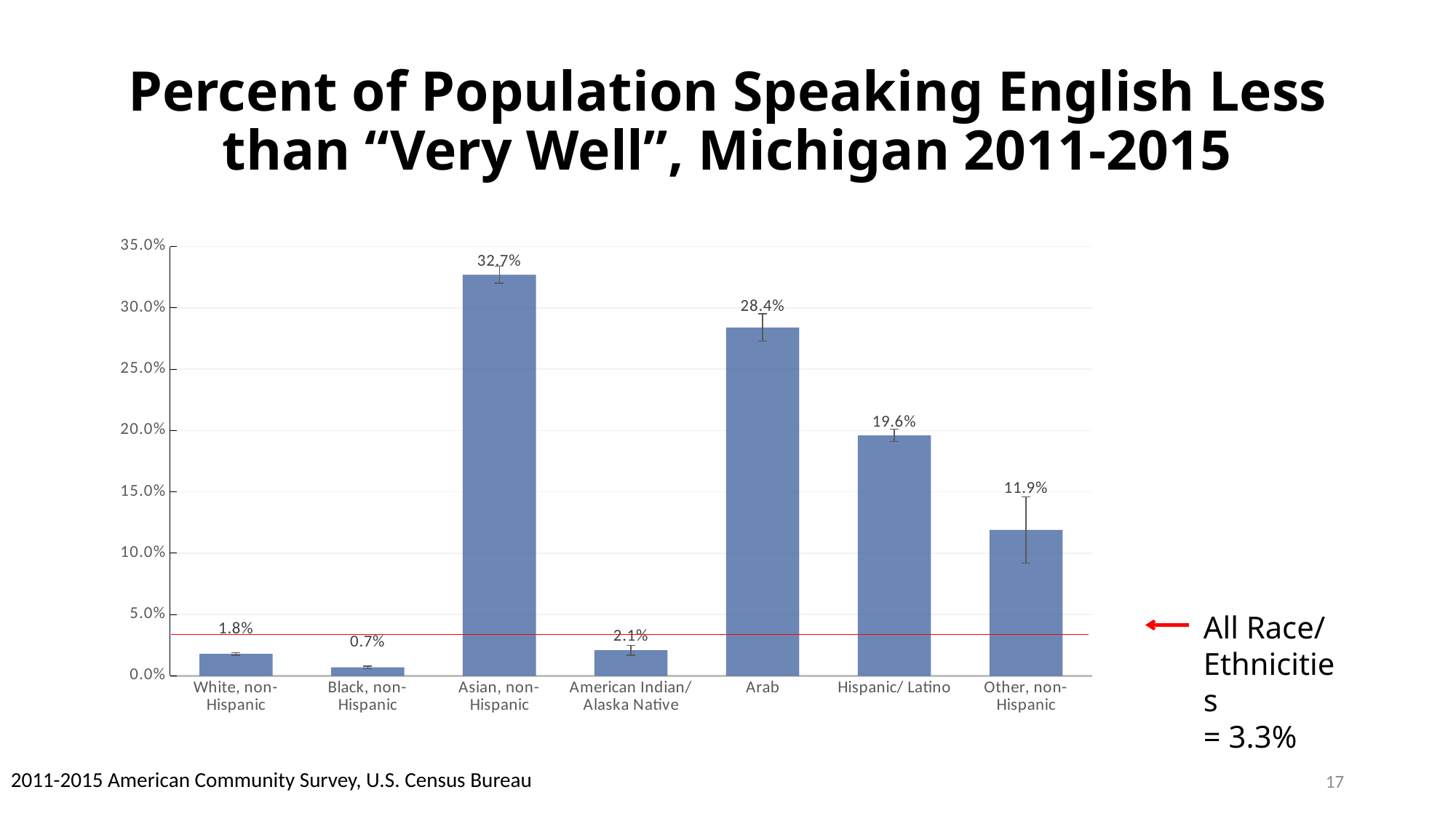
Which is larger, the value for White, non-Hispanic or the value for American Indian/ Alaska Native? American Indian/ Alaska Native What kind of chart is shown on the slide? bar chart How many categories are shown on the x axis? 7 Which category has the highest value? Asian, non-Hispanic What is the value for Arab? 28.4% Which category has the lowest value? Black, non-Hispanic What is the difference between the values for Hispanic/ Latino and Other, non-Hispanic? 7.7% What value does the horizontal reference line for All Race/Ethnicities represent? 3.3% What is the value for Asian, non-Hispanic? 32.7% What is the value for Black, non-Hispanic? 0.7% What is the difference between the values for Asian, non-Hispanic and Arab? 4.3% What is the value for Other, non-Hispanic? 11.9%